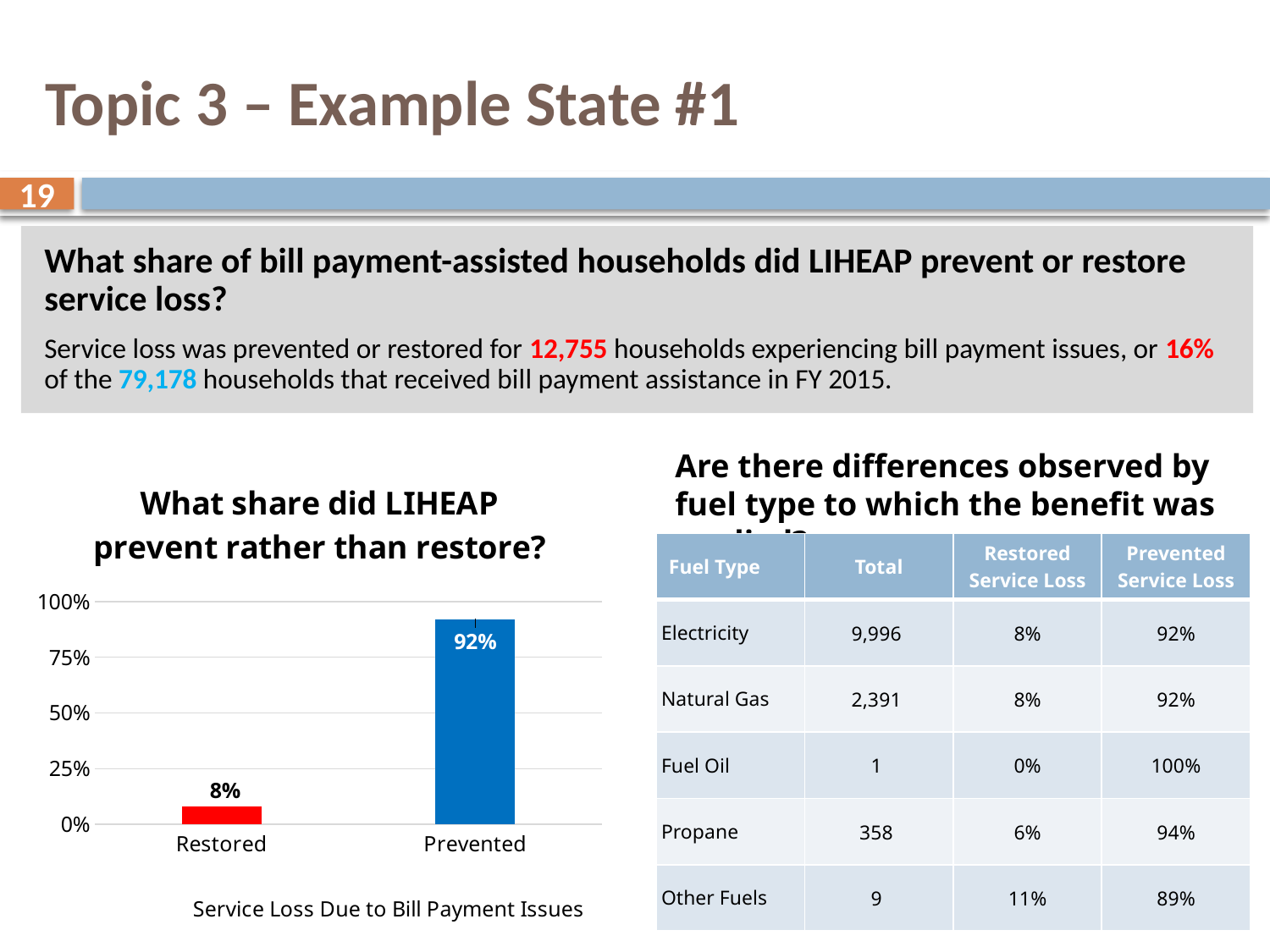
What colour is the Restored bar in the chart? red Which category has the highest value in the chart? Prevented Which is larger in the chart, Restored or Prevented? Prevented How many categories are shown in the chart? 2 Which category has the lowest value in the chart? Restored What is the value for Prevented in the chart? 92% What is the value for Restored in the chart? 8% Is the value for Prevented greater or less than 75%? greater Is the value for Restored greater or less than 25%? less What is the title of the chart? What share did LIHEAP prevent rather than restore? What is the difference between the Prevented and Restored values in the chart? 84% What kind of chart is shown on the slide? bar chart